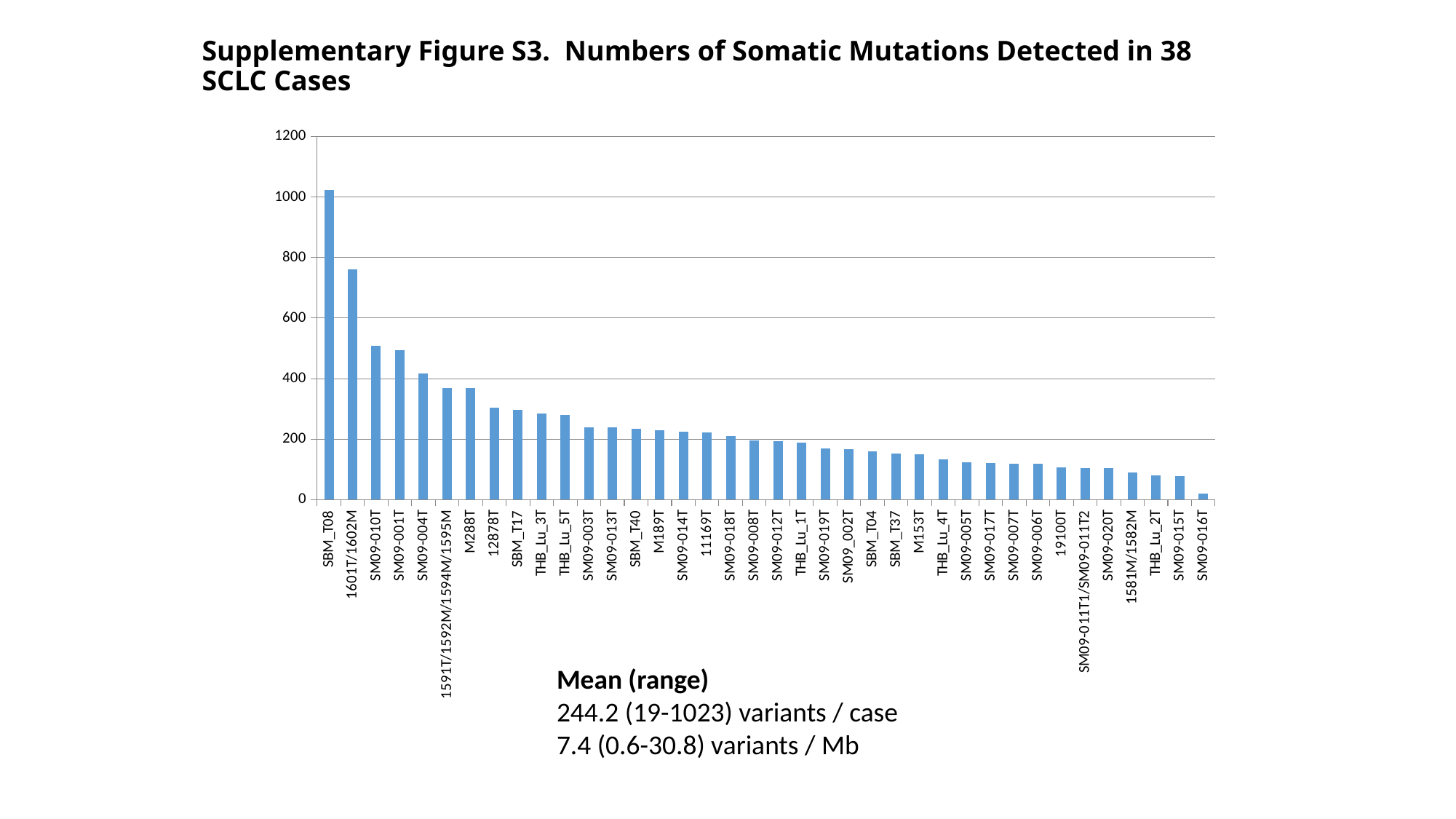
Which case has the highest number of somatic mutations? SBM_T08 Which has more somatic mutations, SBM_T08 or 1601T/1602M? SBM_T08 Which case has the lowest number of somatic mutations? SM09-016T How many cases (bars) are plotted in the chart? 38 Is the value for SM09-010T greater or less than 400? greater What kind of chart is shown on the slide? bar chart Is the value for SBM_T08 greater or less than 800? greater Is the value for 1601T/1602M greater or less than 600? greater Do the values rise or fall moving from left to right along the x axis? fall What is the highest value shown on the y axis? 1200